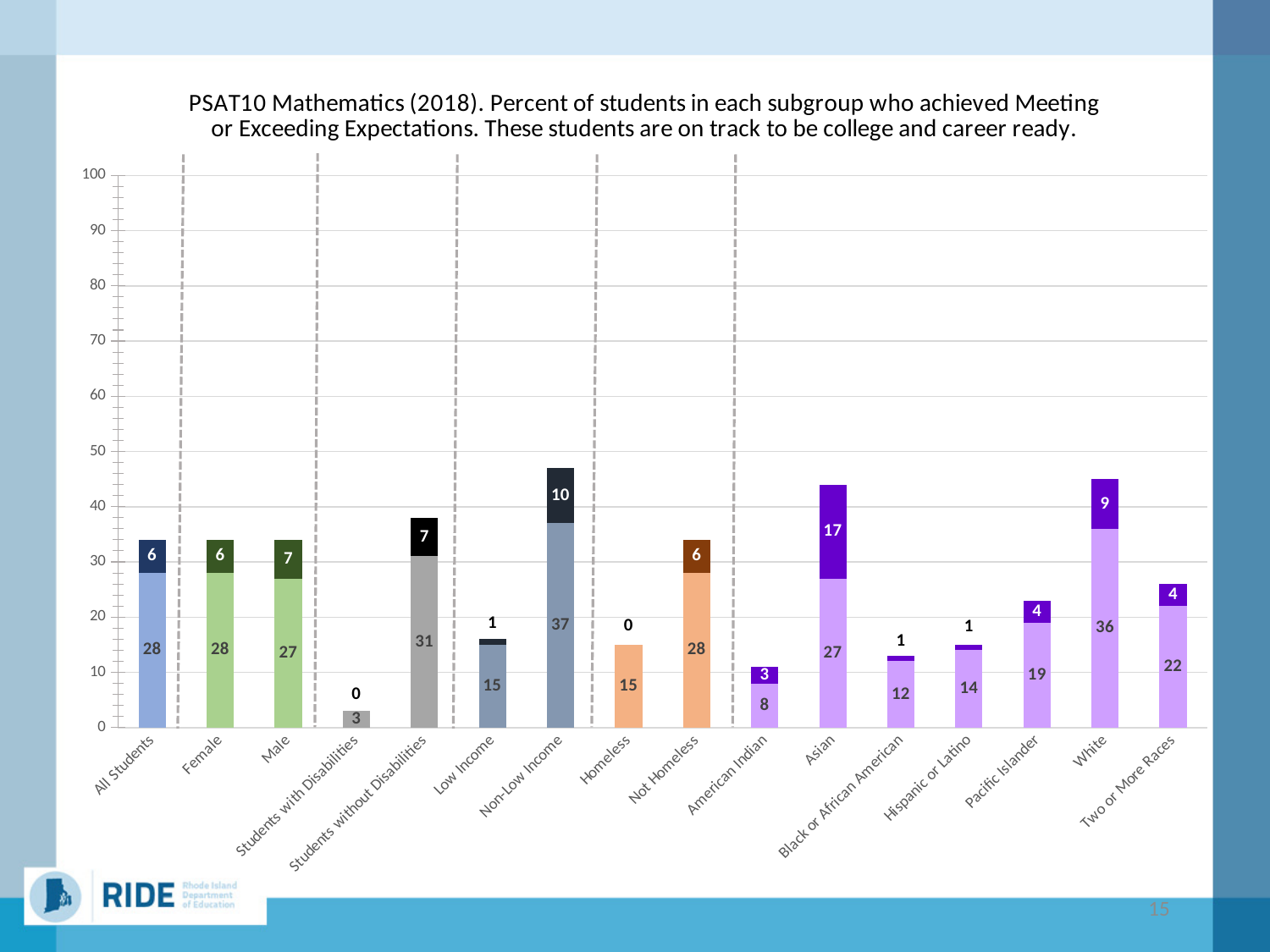
What is the total of the stacked bar for Non-Low Income? 47 Which has a larger lower segment value, Asian or Two or More Races? Asian What type of chart is shown on the slide? stacked bar chart What is the difference between the lower segment values for Non-Low Income and Low Income? 22 What is the total of the stacked bar for Pacific Islander? 23 What is the value of the lower segment of the bar for Students without Disabilities? 31 Which subgroup has the lowest total bar? Students with Disabilities What is the value of the upper segment of the bar for Asian? 17 How many subgroup categories are plotted along the x axis? 16 What is the total of the stacked bar for White? 45 Which subgroup has the highest total bar? Non-Low Income What is the value of the lower segment of the bar for Hispanic or Latino? 14